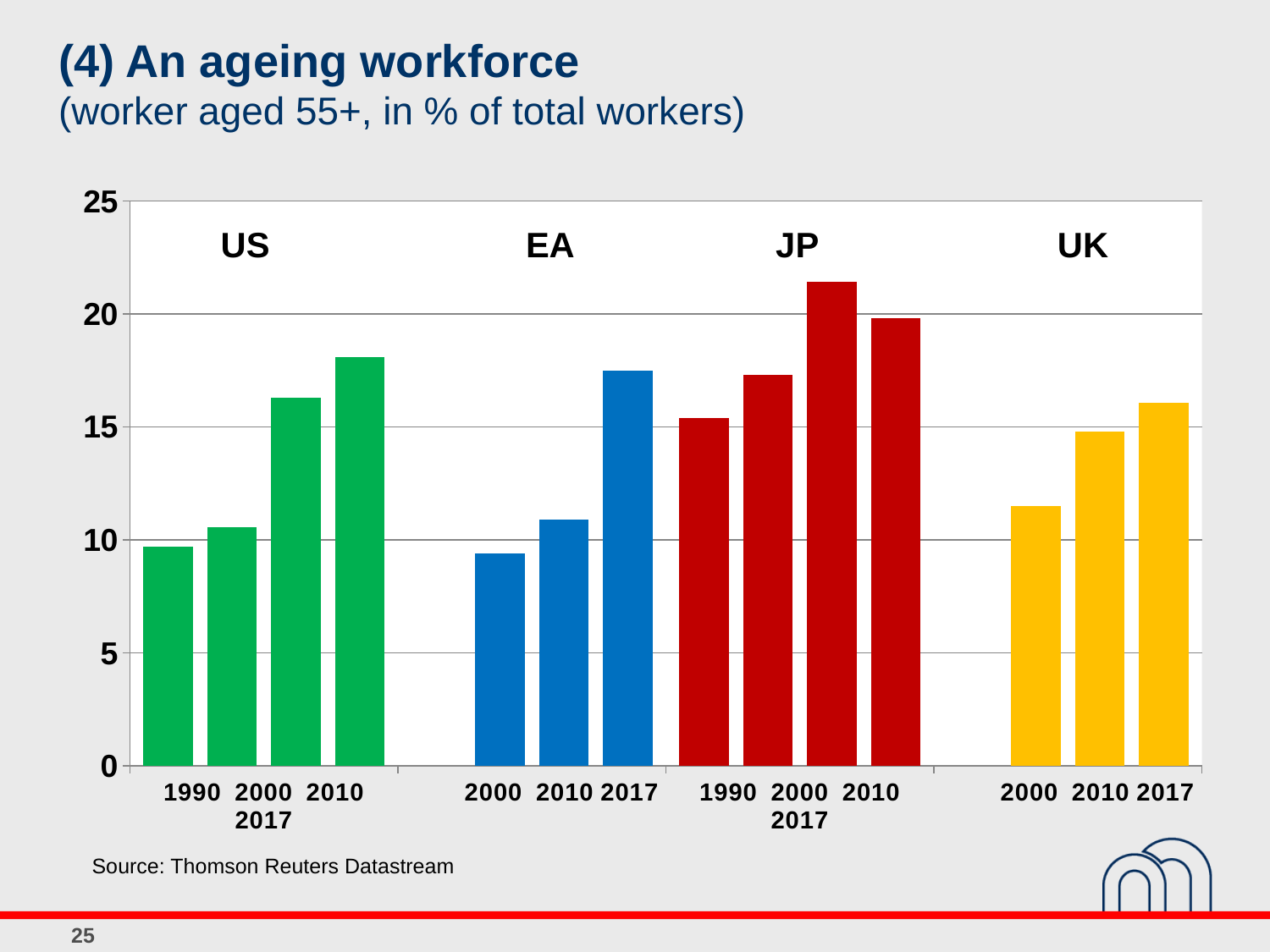
Which is larger, the value for US 2010 or the value for UK 2010? US 2010 Which bar is the highest in the chart? JP 2010 How many bars are plotted in the chart in total? 14 Is the value for EA 2000 greater or less than 10? less Is the value for JP 2010 greater or less than 20? greater Is the value for US 2017 greater or less than 15? greater What kind of chart is shown on the slide? bar chart Do the US values rise or fall from 1990 to 2017? rise Within the JP group, which year has the lowest value? 1990 What colour are the JP bars? red Within the US group, which year has the highest value? 2017